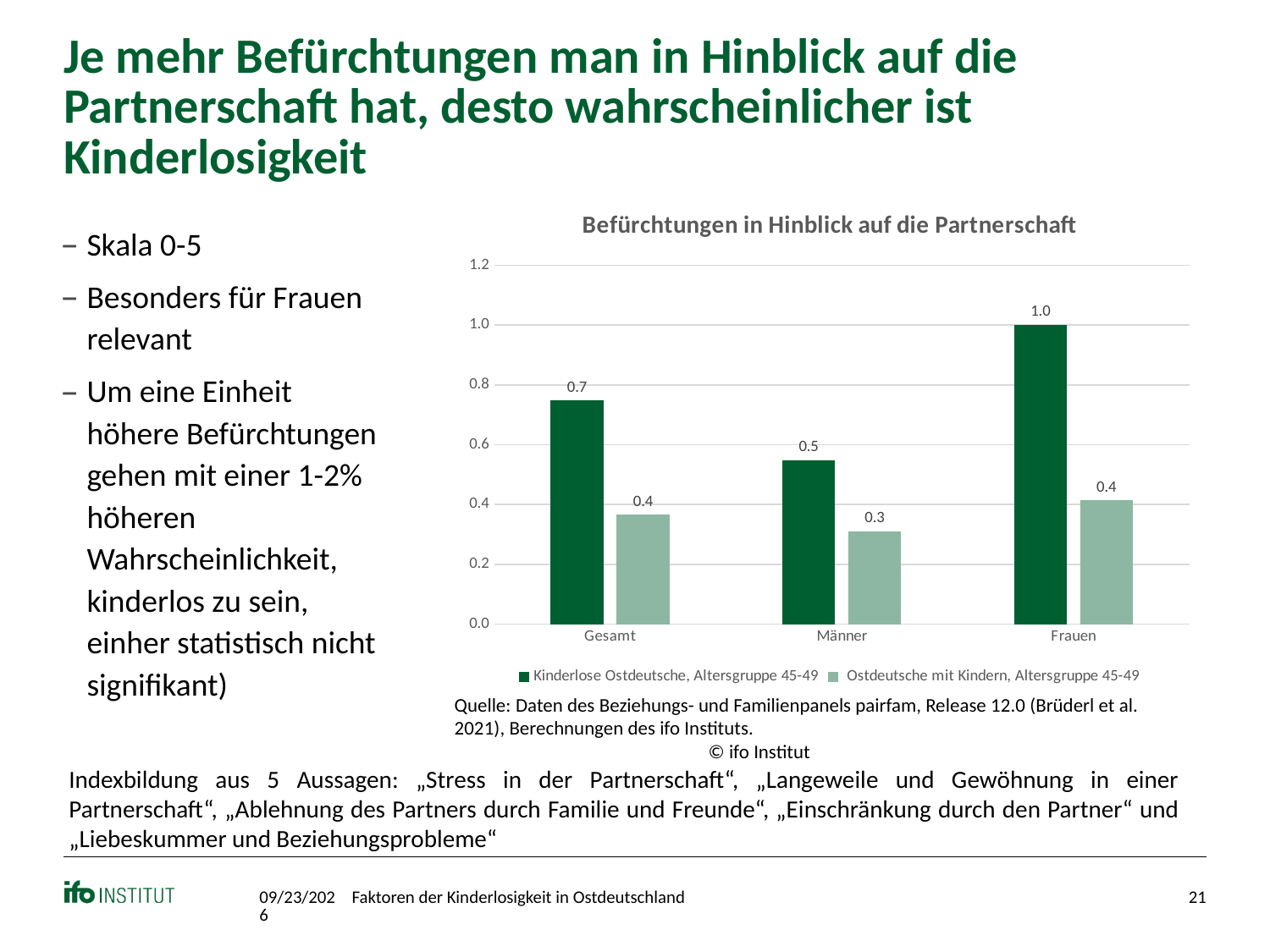
How many categories are shown on the x axis? 3 How many series does the legend list? 2 Which category has the highest value in the series Kinderlose Ostdeutsche, Altersgruppe 45-49? Frauen What is the value for Frauen in the series Kinderlose Ostdeutsche, Altersgruppe 45-49? 1.0 What is the difference between the two series for Frauen? 0.6 What is the difference between the two series for Gesamt? 0.3 What type of chart is shown on the slide? bar chart What is the title of the chart? Befürchtungen in Hinblick auf die Partnerschaft What is the value for Gesamt in the series Kinderlose Ostdeutsche, Altersgruppe 45-49? 0.7 What is the value for Männer in the series Ostdeutsche mit Kindern, Altersgruppe 45-49? 0.3 Which category has the lowest value in the series Ostdeutsche mit Kindern, Altersgruppe 45-49? Männer For Männer, which series has the larger value: Kinderlose Ostdeutsche or Ostdeutsche mit Kindern? Kinderlose Ostdeutsche, Altersgruppe 45-49